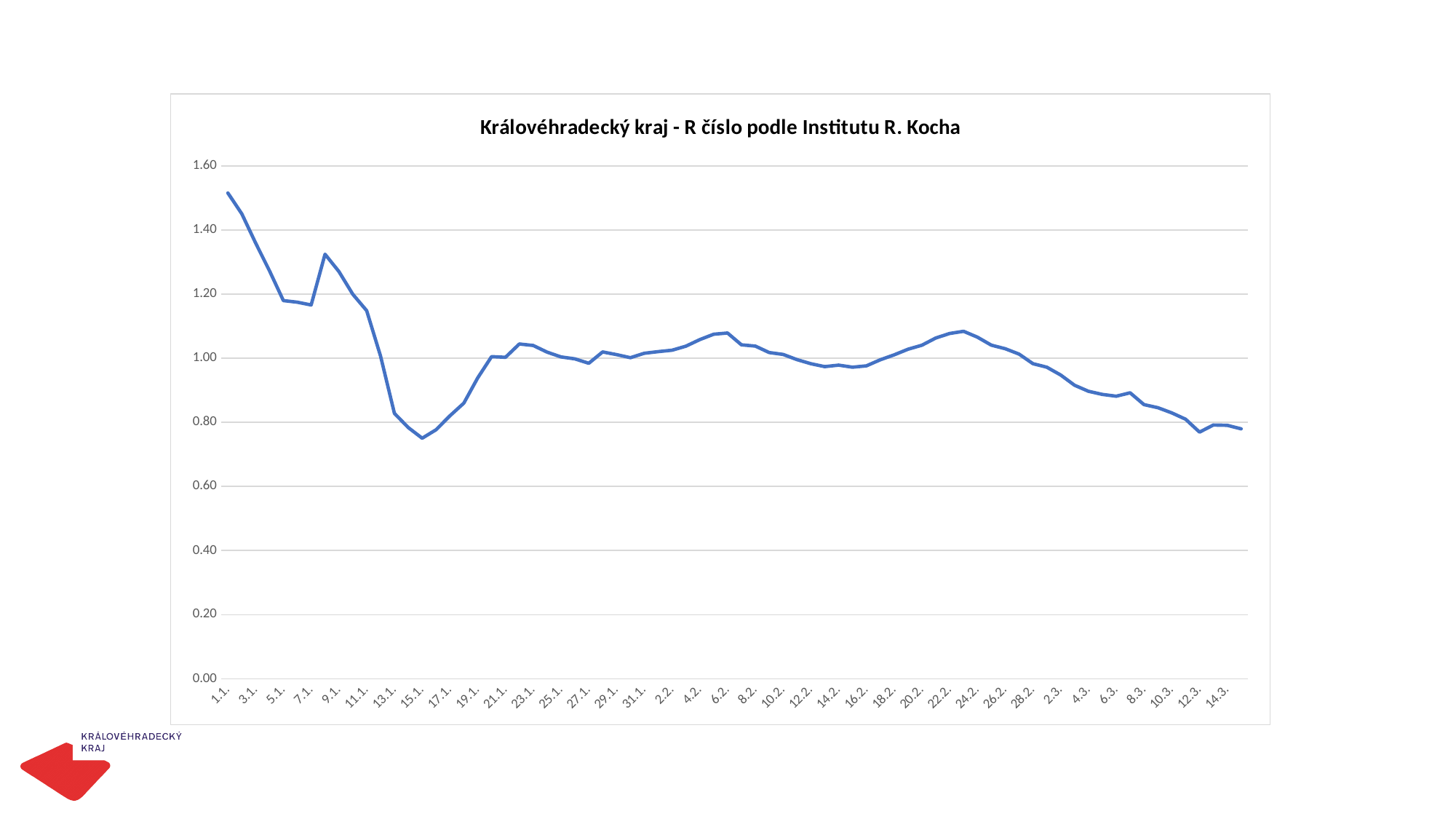
On which date does the line reach its highest value? 1.1. Is the value for 1.1. greater or less than 1.40? greater Which is larger, the value for 1.1. or the value for 14.3.? 1.1. Is the value for 6.2. greater or less than 1.00? greater Is the value for 17.1. greater or less than 1.00? less What kind of chart is shown on the slide? line chart Overall, does the line rise or fall from 1.1. to 14.3.? fall How many date labels are shown on the x axis? 37 What is the title of the chart? Královéhradecký kraj - R číslo podle Institutu R. Kocha